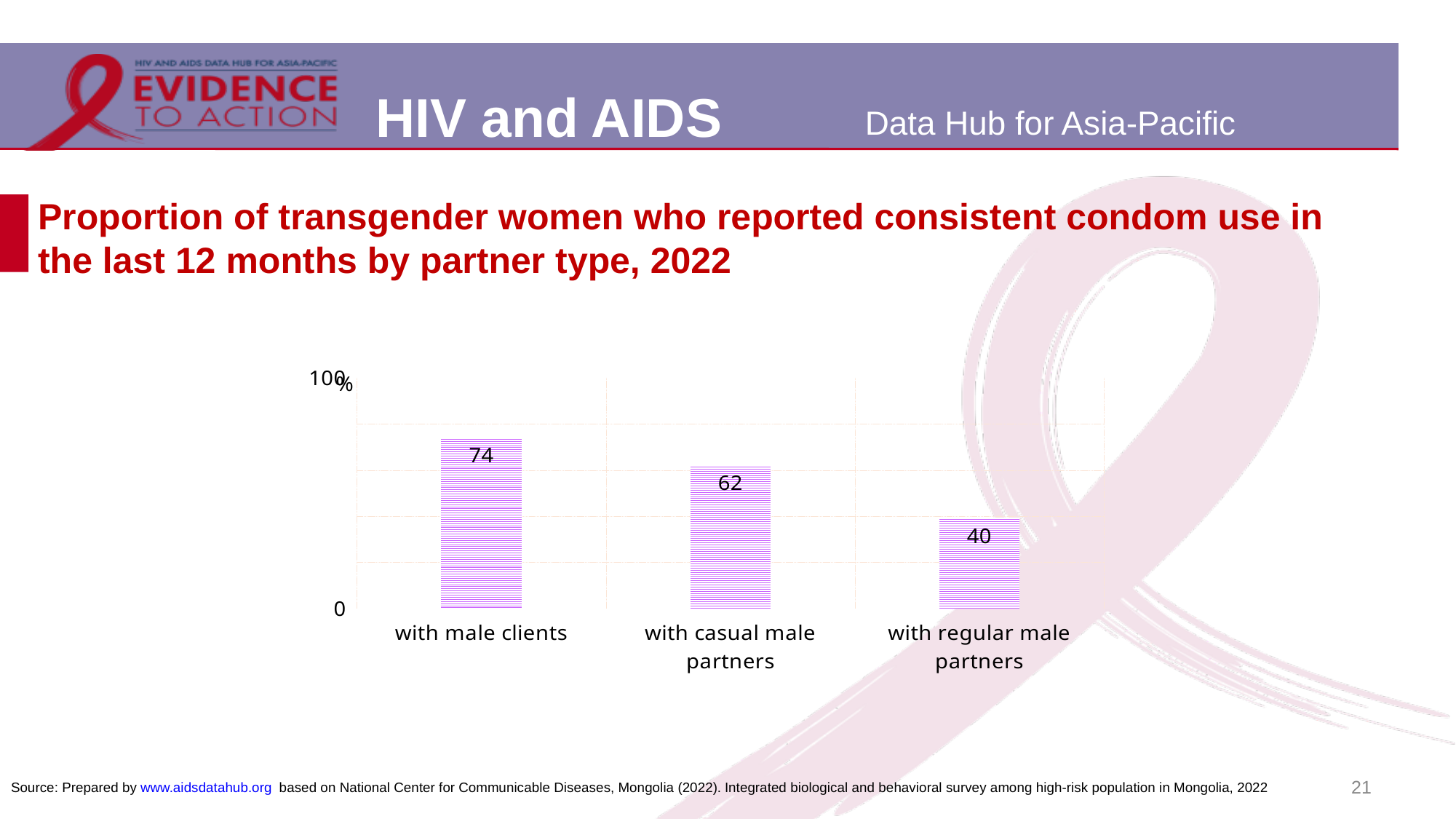
What is the value for 'with regular male partners'? 40 Which partner type has the highest proportion of consistent condom use? with male clients Which is larger, the value for 'with casual male partners' or 'with regular male partners'? with casual male partners What is the maximum value shown on the vertical axis? 100 What is the difference between the values for 'with male clients' and 'with regular male partners'? 34 Which partner type has the lowest proportion of consistent condom use? with regular male partners What kind of chart is shown on the slide? bar chart What is the value for 'with male clients'? 74 What is the difference between the values for 'with male clients' and 'with casual male partners'? 12 Do the values rise or fall from left to right across the categories? fall What is the value for 'with casual male partners'? 62 How many partner-type categories are shown in the chart? 3